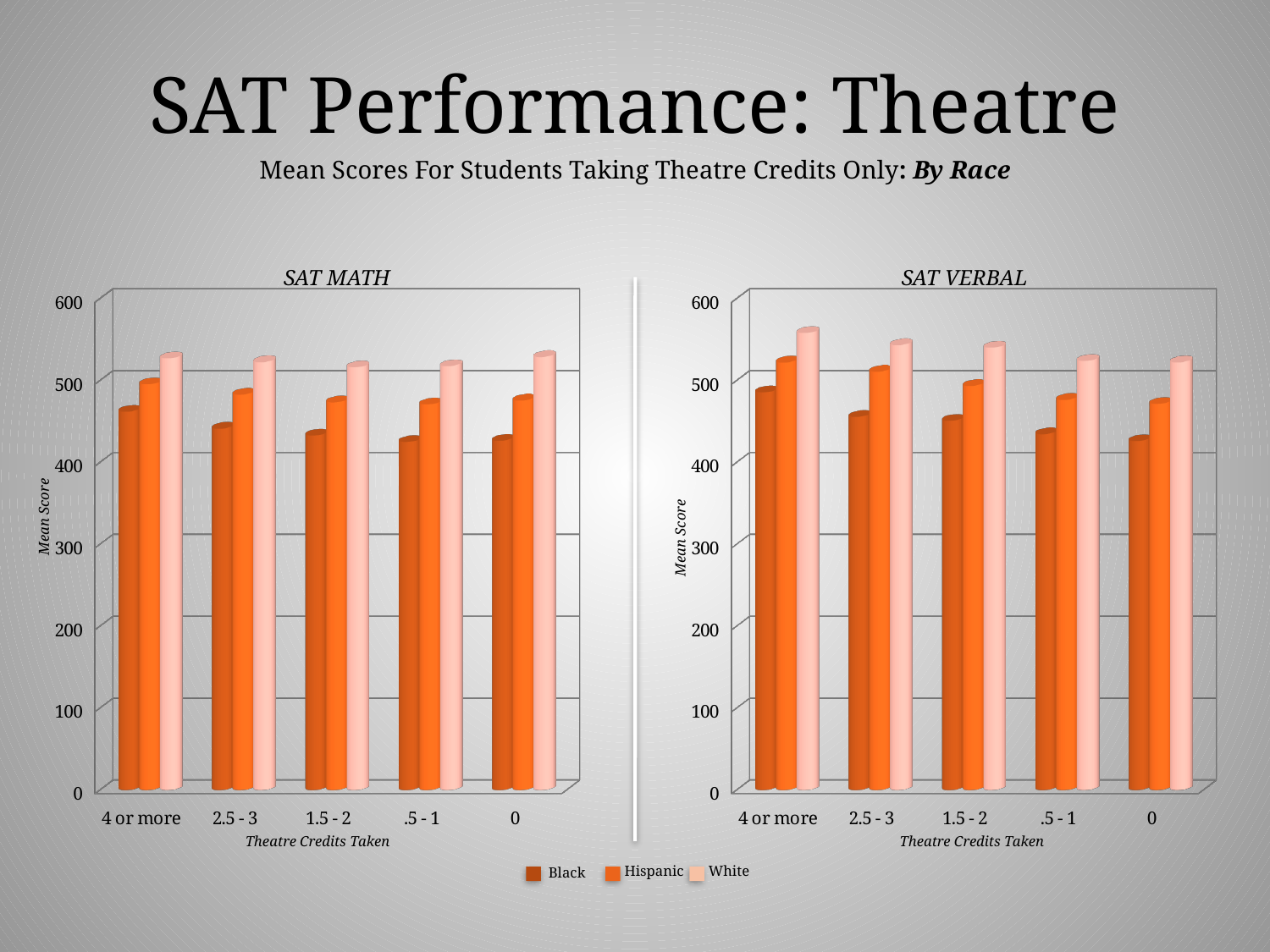
In the SAT MATH chart, is the value for Hispanic students with .5 - 1 theatre credits greater or less than 500? less How many categories are shown on the x axis of the SAT VERBAL chart? 5 In the SAT VERBAL chart, is the value for White students with 4 or more theatre credits greater or less than 500? greater In the SAT VERBAL chart, which theatre credits category has the highest value for White students? 4 or more What kind of chart is the SAT MATH chart? bar chart In the SAT MATH chart, is the value for White students with 4 or more theatre credits greater or less than 500? greater In the SAT MATH chart, for students with 4 or more theatre credits, which is larger: the White value or the Black value? White What is the label on the x axis of the SAT VERBAL chart? Theatre Credits Taken In the SAT MATH chart, which theatre credits category has the highest value for Black students? 4 or more In the SAT VERBAL chart, do the values for Black students rise or fall moving from 4 or more credits to 0 credits along the x axis? fall How many series does the legend list? 3